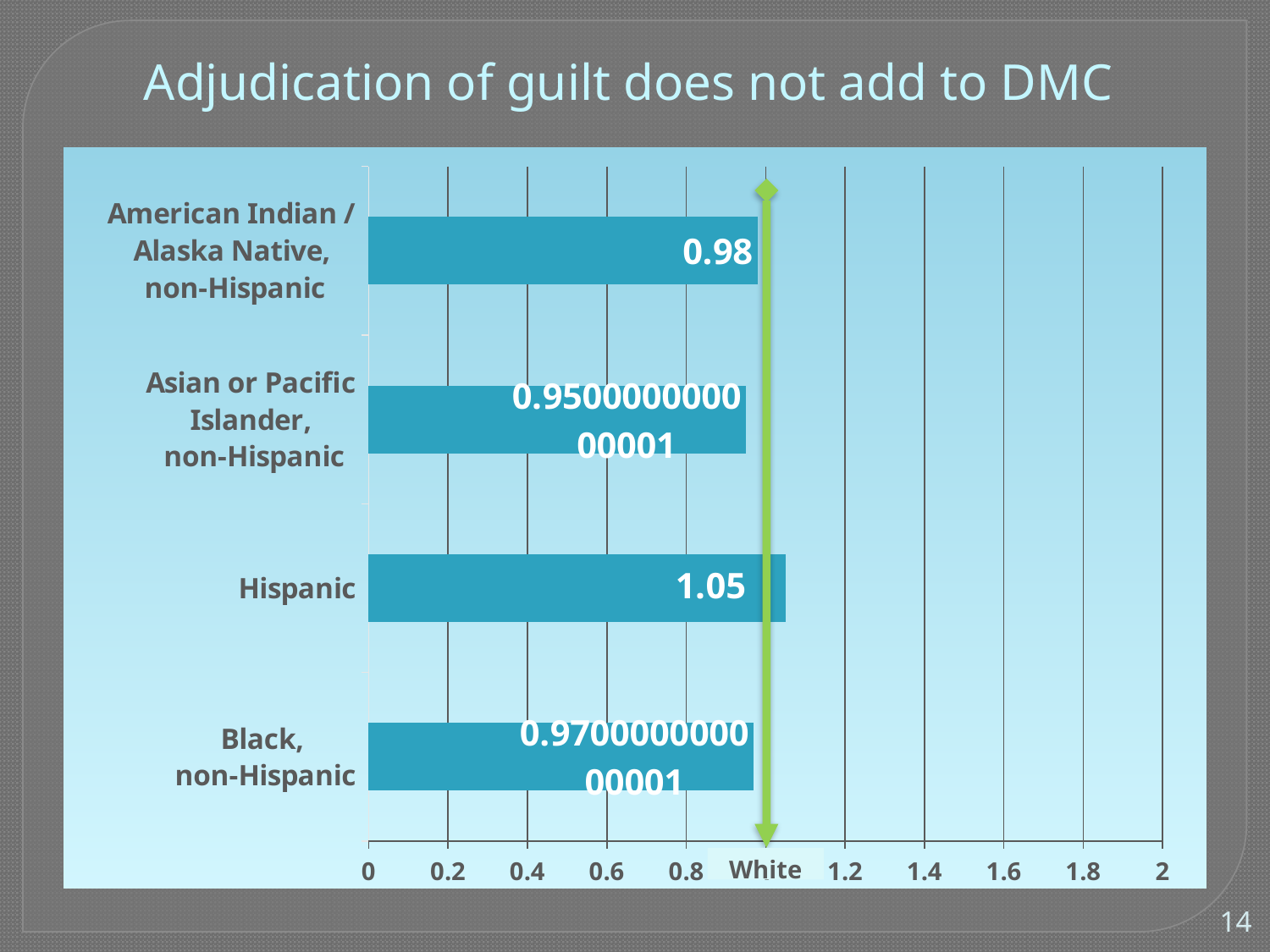
How many categories are shown in the chart? 4 What is the value for American Indian / Alaska Native, non-Hispanic? 0.98 What label is attached to the green vertical reference line on the chart? White Which category has the lowest value? Asian or Pacific Islander, non-Hispanic What is the difference between the values for Hispanic and American Indian / Alaska Native, non-Hispanic? 0.07 What value is labelled on the bar for Black, non-Hispanic? 0.970000000000001 What value is labelled on the bar for Asian or Pacific Islander, non-Hispanic? 0.950000000000001 What kind of chart is shown on the slide? bar chart Which is larger, the value for Hispanic or the value for American Indian / Alaska Native, non-Hispanic? Hispanic What is the value for Hispanic? 1.05 Is the value for Hispanic greater or less than 1.2? less Which category has the highest value? Hispanic